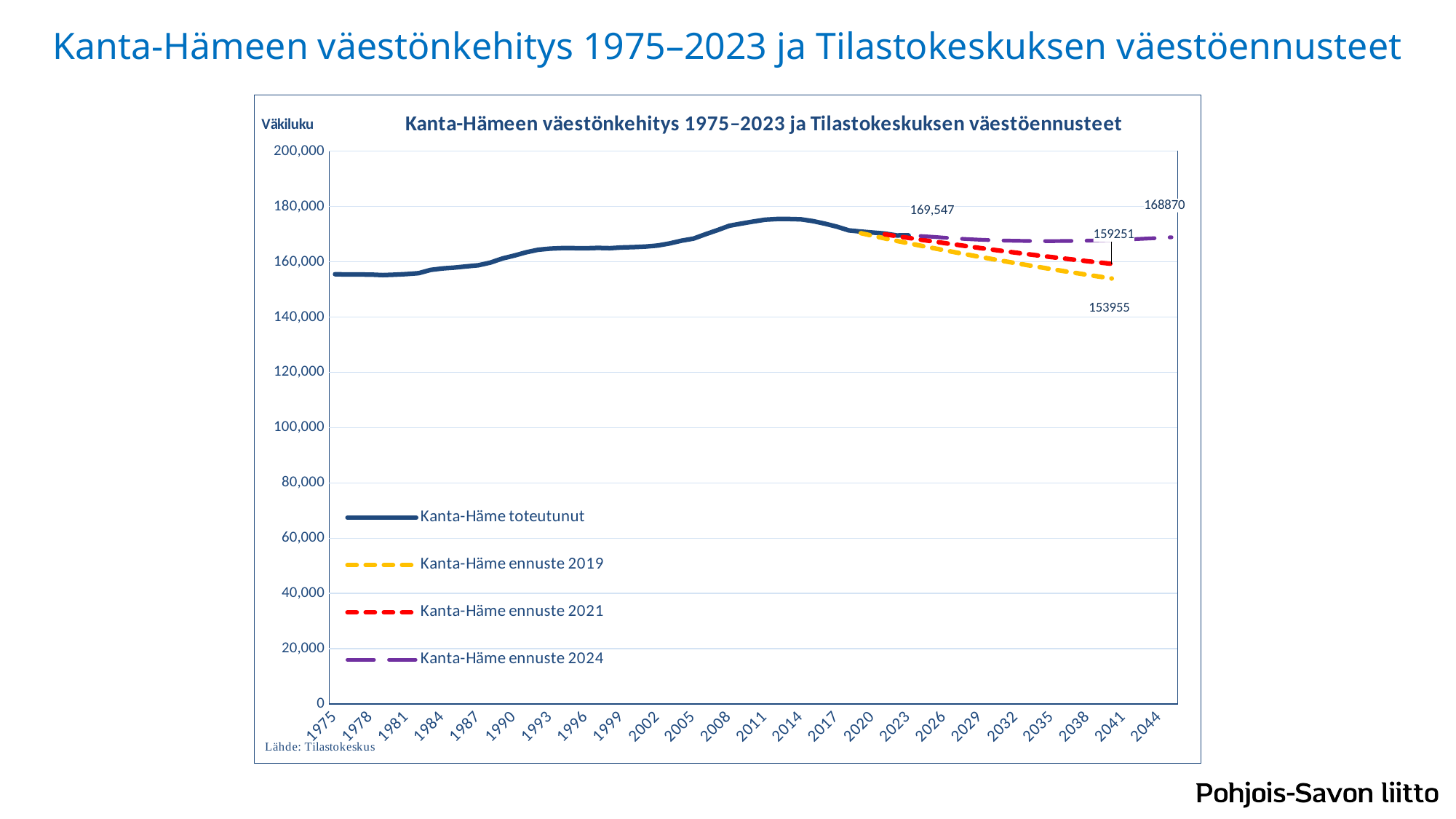
What is the difference between the labelled end values of the ennuste 2024 and ennuste 2019 series? 14915 What is the labelled end value of the Kanta-Häme ennuste 2019 series? 153955 What is the difference between the labelled end values of the ennuste 2021 and ennuste 2019 series? 5296 Which ends higher, the ennuste 2021 series or the ennuste 2019 series? Kanta-Häme ennuste 2021 Which forecast series ends at the lowest labelled value? Kanta-Häme ennuste 2019 What source is cited below the chart? Tilastokeskus What is the labelled end value of the Kanta-Häme ennuste 2024 series? 168870 Is the Kanta-Häme toteutunut value in 1975 greater or less than 140,000? greater What kind of chart is shown on the slide? line chart What is the labelled end value of the Kanta-Häme ennuste 2021 series? 159251 How many series does the legend list? 4 What value is labelled at the end of the Kanta-Häme toteutunut line? 169,547